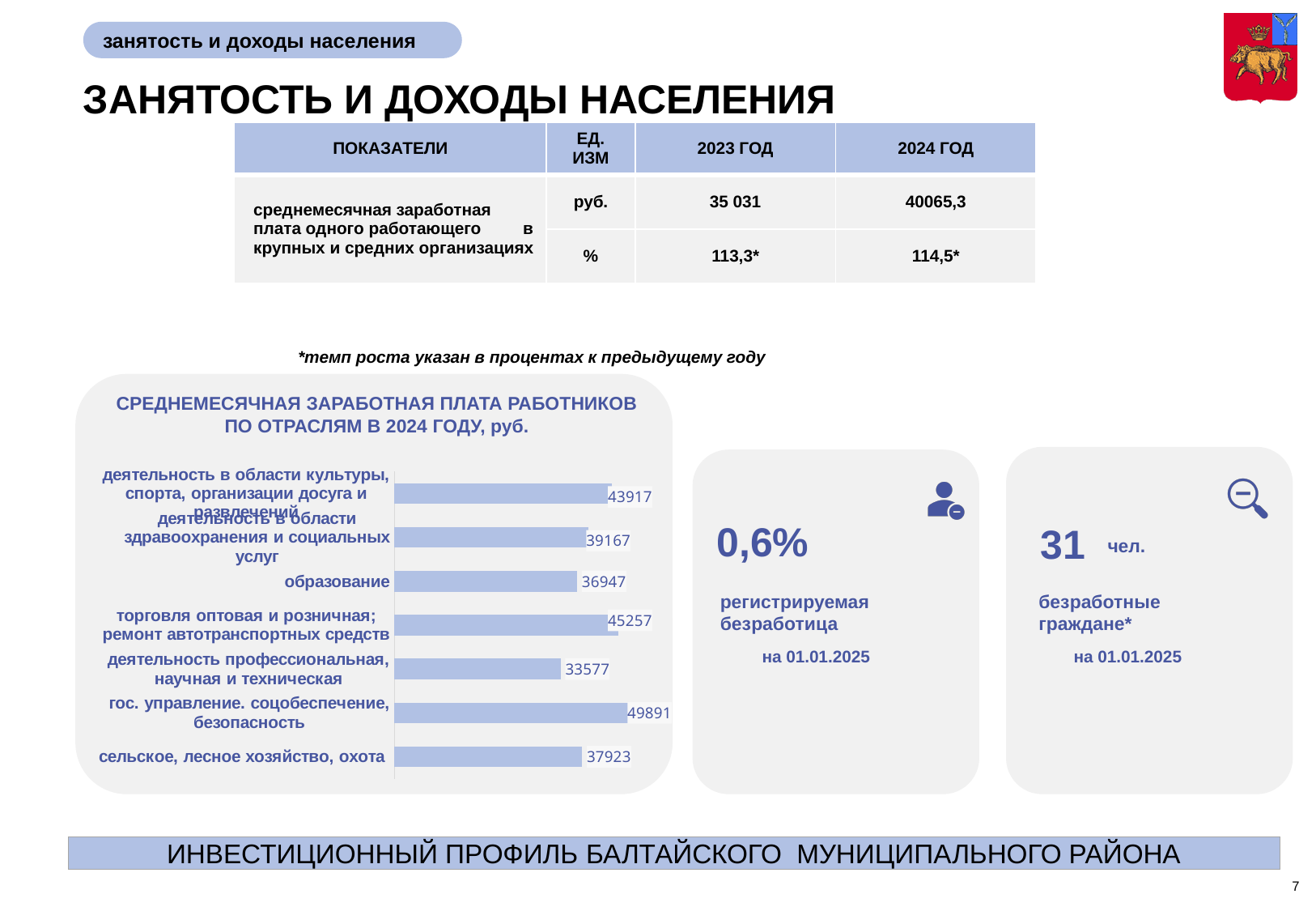
How many sectors are shown in the bar chart? 7 What year does the bar chart of salaries by sector refer to? 2024 Which sector has the lowest average monthly salary in the bar chart? деятельность профессиональная, научная и техническая What type of chart is used to show average monthly salary by sector? bar chart Which sector has the highest average monthly salary in the bar chart? гос. управление. соцобеспечение, безопасность Which is larger: the salary for торговля оптовая и розничная or for деятельность в области культуры, спорта? торговля оптовая и розничная; ремонт автотранспортных средств Which is larger: the salary for сельское, лесное хозяйство, охота or for деятельность профессиональная, научная и техническая? сельское, лесное хозяйство, охота What value is shown for сельское, лесное хозяйство, охота in the bar chart? 37923 What is the value for торговля оптовая и розничная; ремонт автотранспортных средств in the bar chart? 45257 How much higher is the salary for деятельность в области здравоохранения и социальных услуг than for образование? 2220 What is the difference between the highest and lowest values in the bar chart? 16314 What is the average monthly salary for образование in the bar chart? 36947